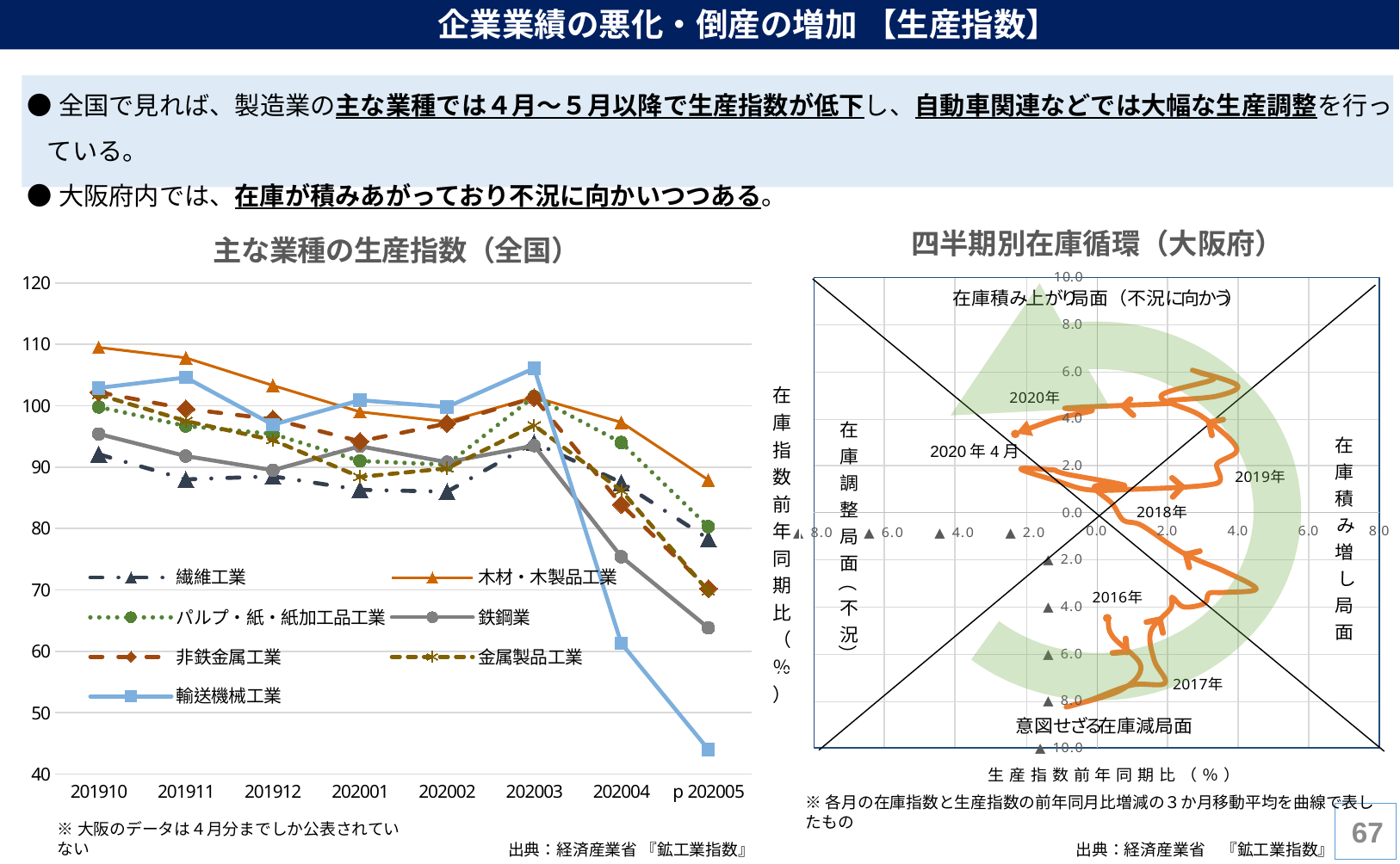
In the chart 主な業種の生産指数（全国）, how many time points are shown on the x axis? 8 In the chart 主な業種の生産指数（全国）, is the value for 木材・木製品工業 at 201910 greater or less than 100? greater In the chart 主な業種の生産指数（全国）, which series has the lowest value at p 202005? 輸送機械工業 In the chart 主な業種の生産指数（全国）, which series has the highest value at 201910? 木材・木製品工業 In the chart 主な業種の生産指数（全国）, is the value for 輸送機械工業 at 202003 greater or less than 100? greater In the chart 主な業種の生産指数（全国）, does the value for 輸送機械工業 rise or fall from 202003 to p 202005? fall In the chart 主な業種の生産指数（全国）, how many series does the legend list? 7 What kind of chart is the left chart titled 主な業種の生産指数（全国）? line chart In the chart 主な業種の生産指数（全国）, at p 202005, which is larger: 木材・木製品工業 or 鉄鋼業? 木材・木製品工業 What is the title of the chart on the right side of the slide? 四半期別在庫循環（大阪府） In the chart 主な業種の生産指数（全国）, is the value for 輸送機械工業 at p 202005 greater or less than 50? less